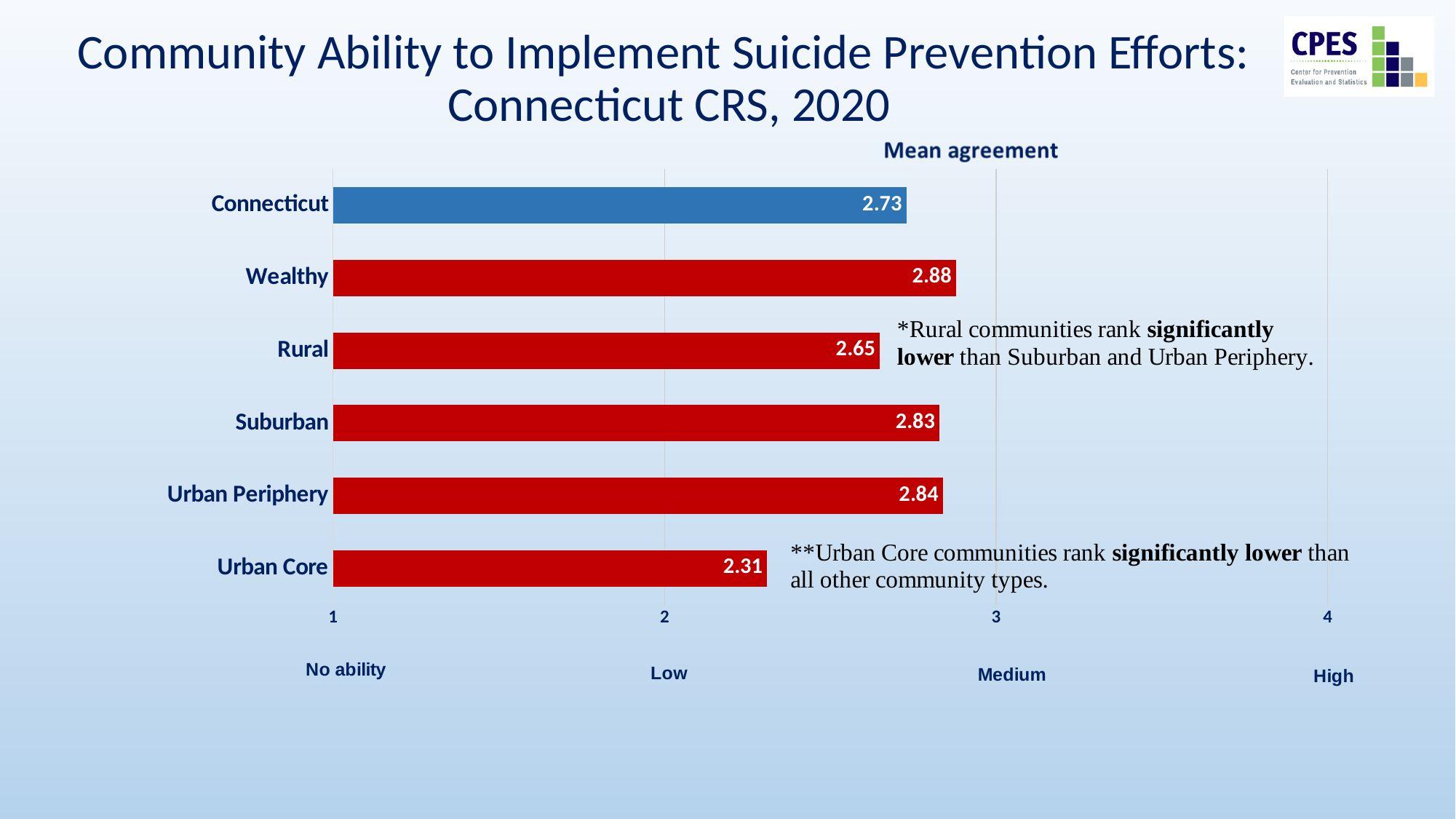
Which community type has the highest mean agreement? Wealthy What is the difference between the mean agreement for Wealthy and Urban Core communities? 0.57 What is the title shown above the chart's plot area? Mean agreement What is the mean agreement value for Rural communities? 2.65 What is the difference between the mean agreement for Suburban and Rural communities? 0.18 What kind of chart is shown on the slide? bar chart What is the mean agreement value for Connecticut? 2.73 How many bars are shown in the chart? 6 Is the mean agreement for Urban Core greater or less than 3? less Which community type has the lowest mean agreement? Urban Core What is the mean agreement value for Urban Core communities? 2.31 Which has a higher mean agreement, Rural or Suburban? Suburban